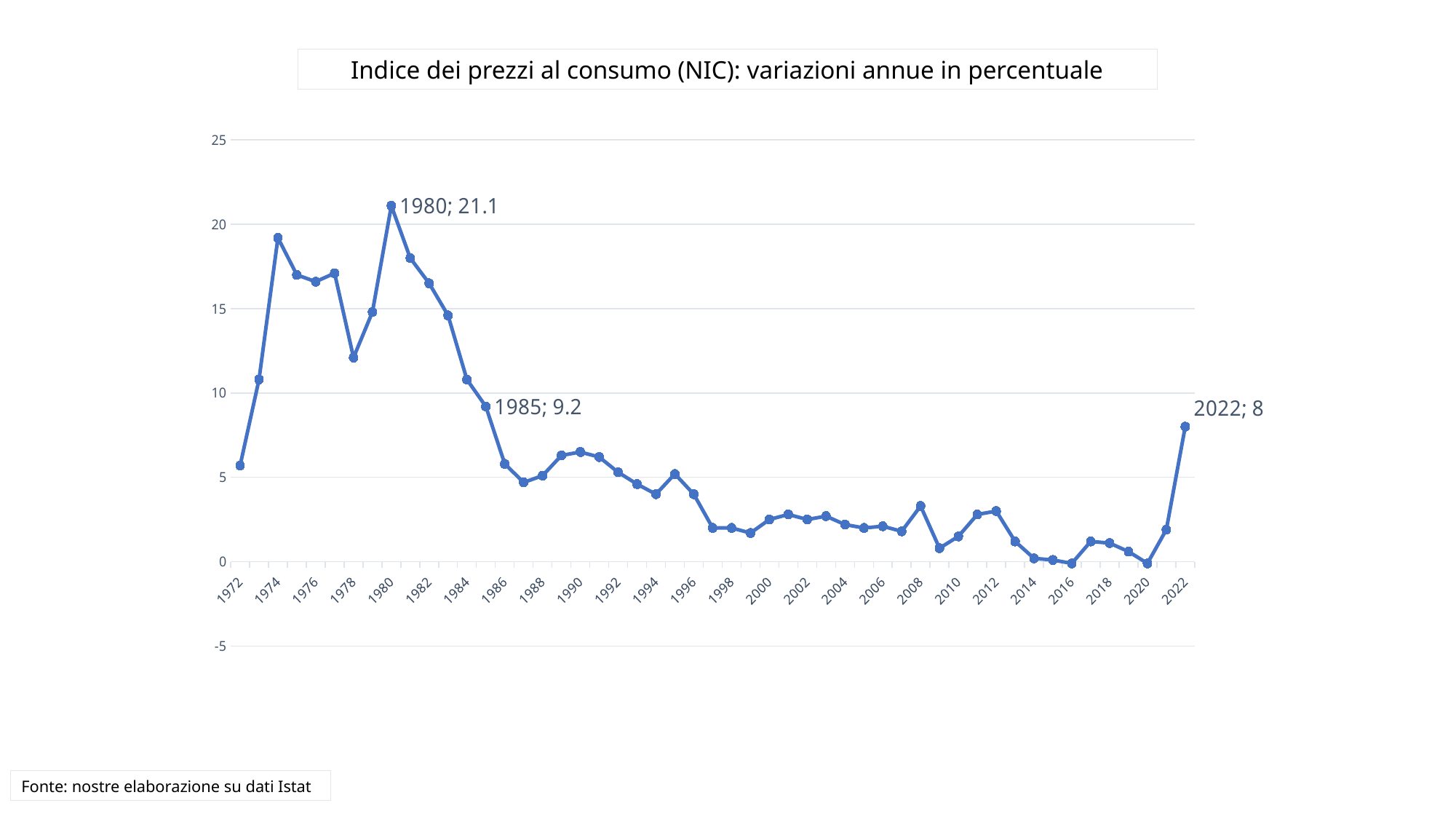
What is the title of the chart? Indice dei prezzi al consumo (NIC): variazioni annue in percentuale What is the difference between the values for 1985 and 2022? 1.2 What is the value for 2022? 8 What is the value for 1980? 21.1 What is the difference between the values for 1980 and 1985? 11.9 Which year has the highest value? 1980 What kind of chart is shown? line chart Which is larger, the value for 1980 or the value for 2022? 1980 Do the values rise or fall from 1980 to 1985? fall Is the value for 1996 greater or less than 5? less What is the value for 1985? 9.2 Is the value for 1974 greater or less than 15? greater